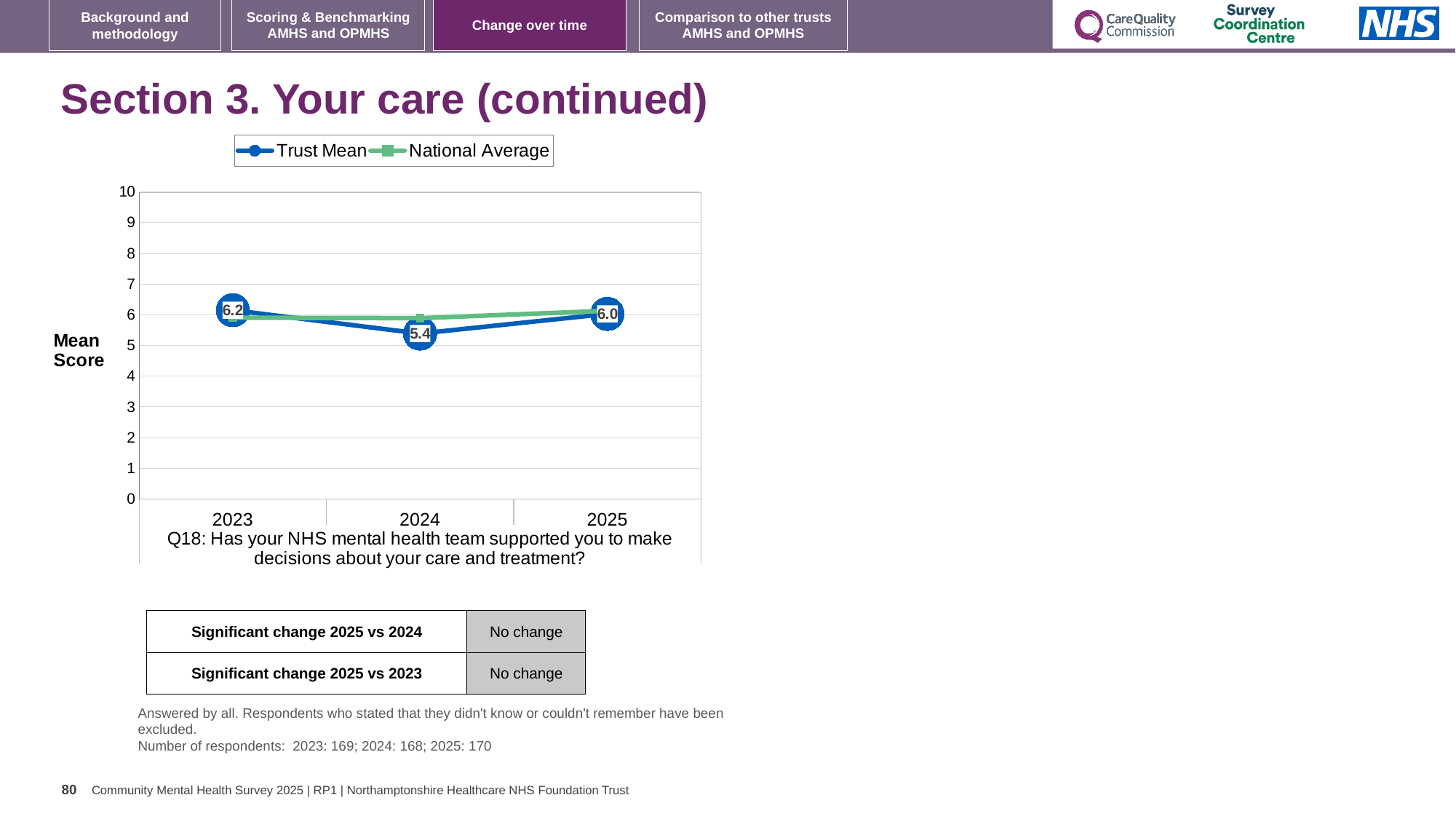
What is the Trust Mean score for 2025? 6.0 What kind of chart is shown on the slide? Line chart What is the Trust Mean score for 2024? 5.4 Is the National Average value for 2024 greater or less than 5? greater In which year is the Trust Mean score highest? 2023 Does the Trust Mean score rise or fall from 2023 to 2024? Fall In which year is the Trust Mean score lowest? 2024 In 2024, which is higher: the Trust Mean or the National Average? National Average What is the difference between the Trust Mean score in 2023 and in 2024? 0.8 What is the Trust Mean score for 2023? 6.2 How many series does the chart legend list? 2 How many years are shown on the x axis of the chart? 3